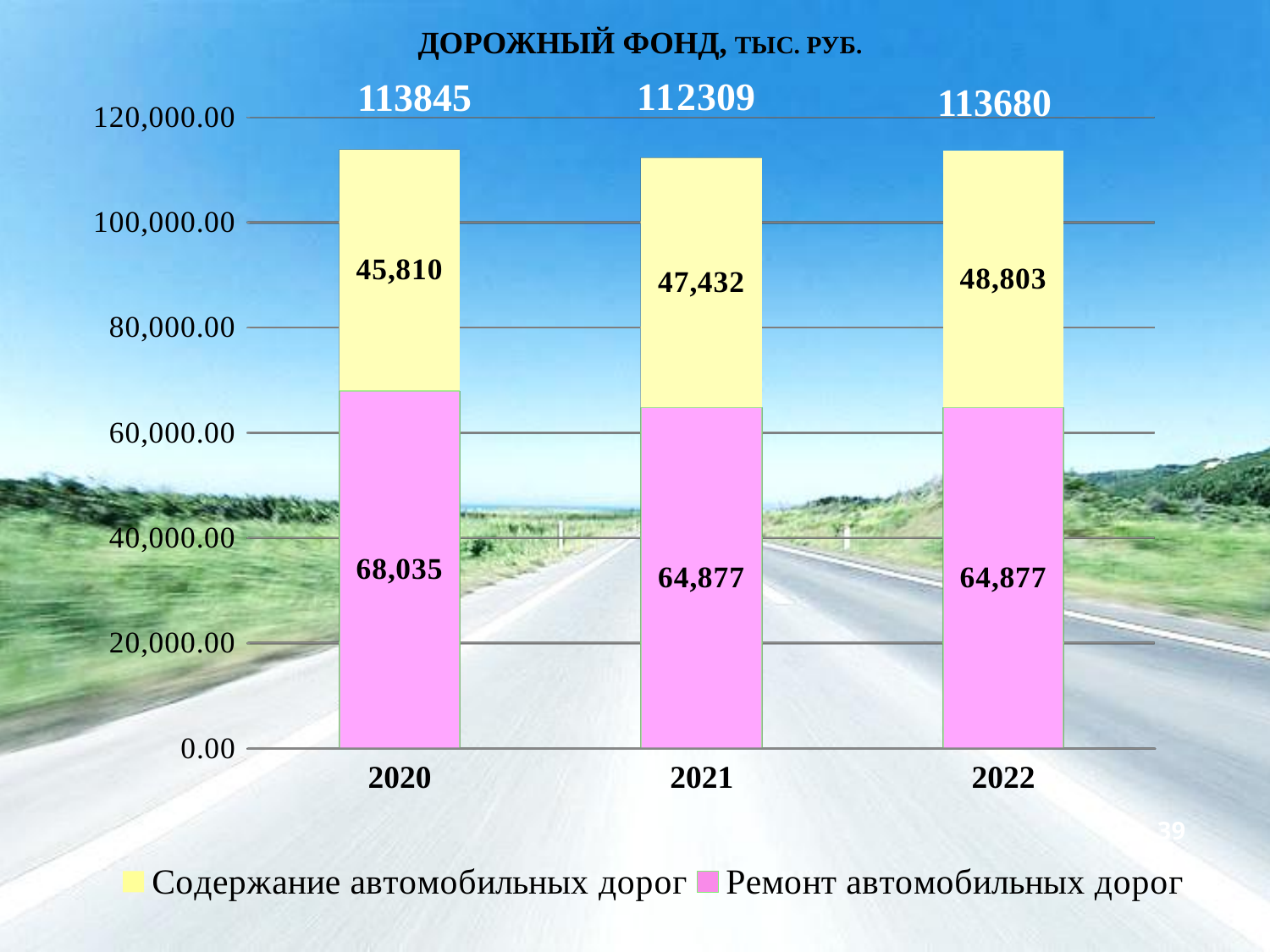
Which year has the highest value for Содержание автомобильных дорог? 2022 How many series does the legend list? 2 How many years are shown on the x axis? 3 What is the total of the stacked bar for 2021? 112309 Does the value for Содержание автомобильных дорог rise or fall from 2020 to 2022? Rise What is the difference between Ремонт автомобильных дорог in 2020 and in 2021? 3,158 What is the value for Содержание автомобильных дорог in 2022? 48,803 Which year has the lowest total for the road fund? 2021 What is the value for Содержание автомобильных дорог in 2020? 45,810 What is the value for Ремонт автомобильных дорог in 2021? 64,877 What type of chart is shown on the slide? Stacked bar chart Which is larger in 2022: Содержание автомобильных дорог or Ремонт автомобильных дорог? Ремонт автомобильных дорог